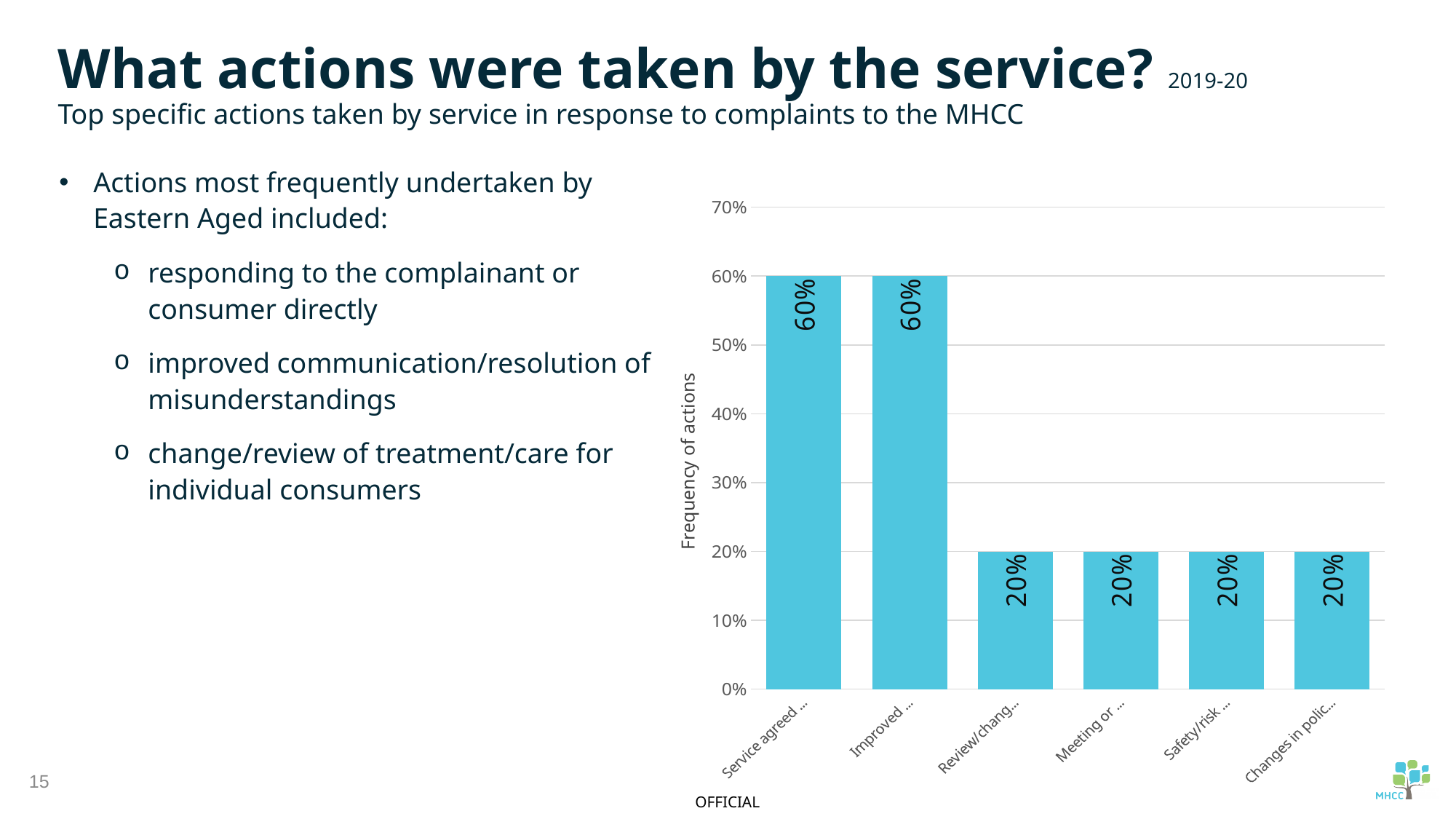
Is the value for "Service agreed ..." greater or less than 50%? greater What is the label on the vertical axis of the chart? Frequency of actions What is the value for the "Service agreed ..." category? 60% What is the difference between the values for "Service agreed ..." and "Meeting or ..."? 40% How many categories are shown on the x axis? 6 What kind of chart is shown on the slide? bar chart Which has the larger value, "Improved ..." or "Changes in polic..."? Improved ... What is the highest value shown in the chart? 60% What is the value for the "Safety/risk ..." category? 20% What is the value for the "Improved ..." category? 60% How many bars have a value of 20%? 4 What is the value for the "Review/chang..." category? 20%